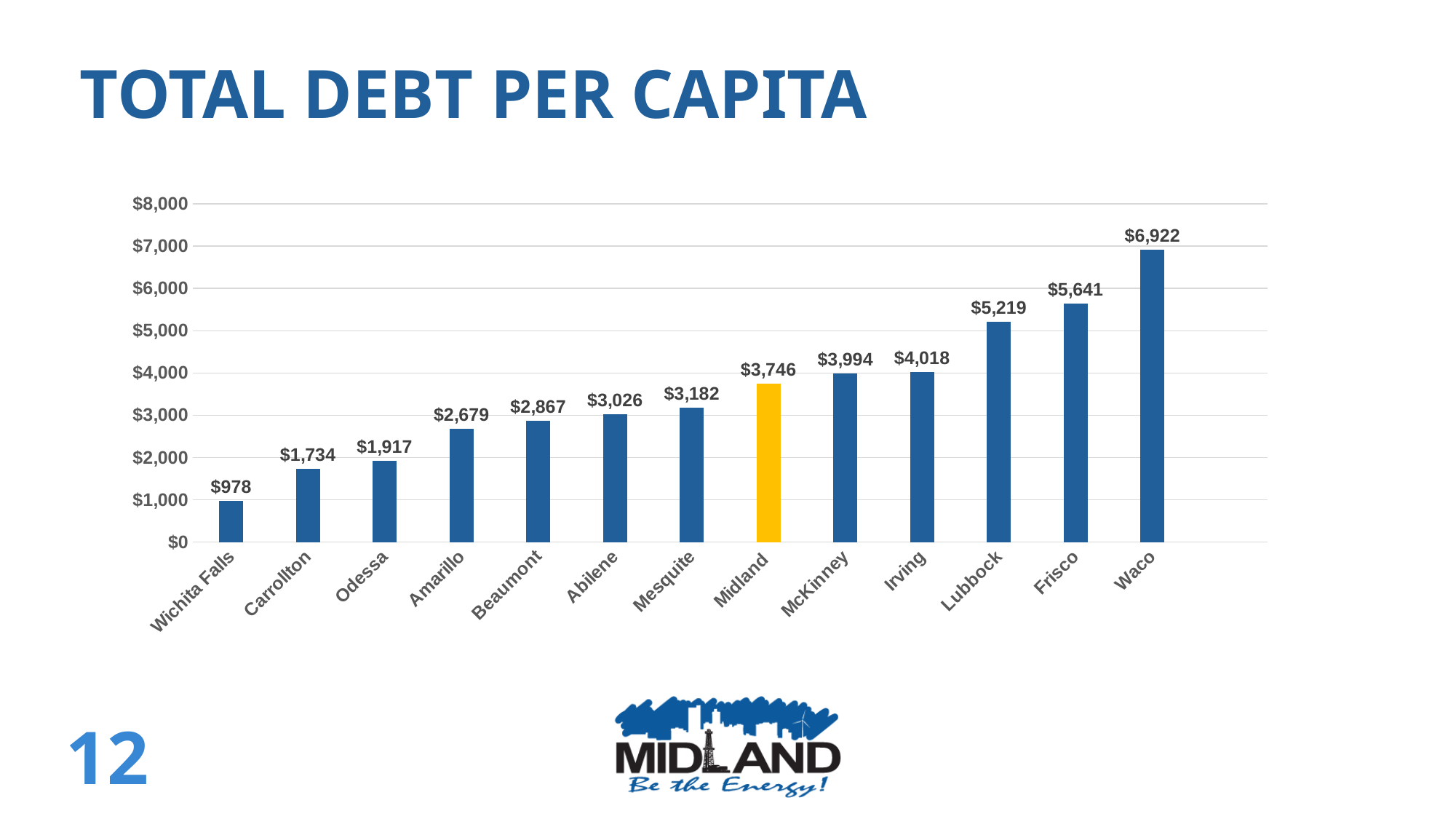
What is the title of the chart? TOTAL DEBT PER CAPITA Do the values rise or fall from left to right across the cities? Rise What is the difference in total debt per capita between Waco and Midland? $3,176 What is the total debt per capita for Lubbock? $5,219 Which city has the lowest total debt per capita? Wichita Falls Which city has the highest total debt per capita? Waco Which city has a higher total debt per capita, Frisco or Irving? Frisco Is the value for Amarillo greater or less than $3,000? less How many cities are shown in the chart? 13 Which city's bar is highlighted in yellow? Midland What is the total debt per capita for Midland? $3,746 What kind of chart is shown on the slide? Bar chart